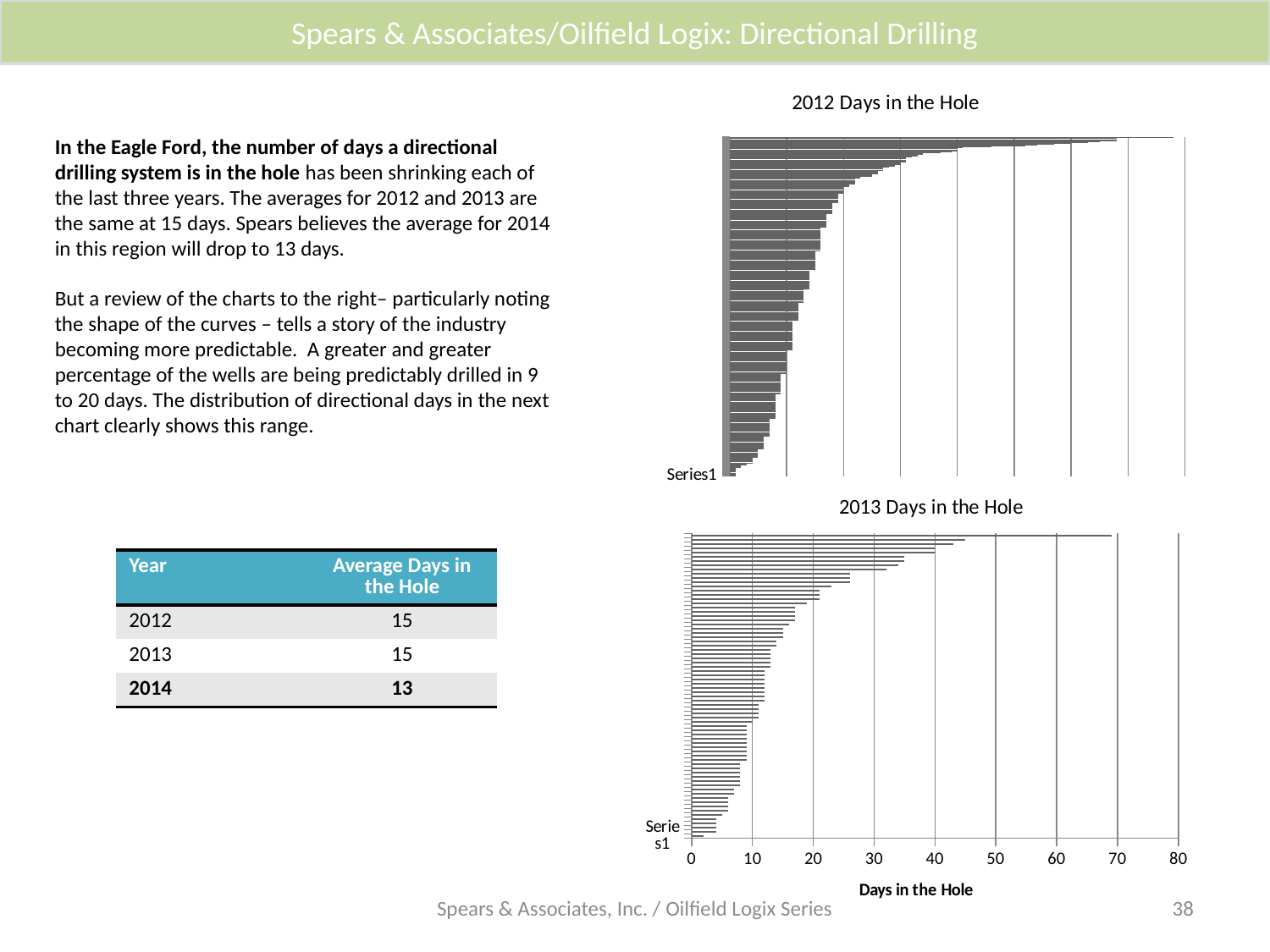
In the "2013 Days in the Hole" chart, is the value of the longest bar greater or less than 60? greater In the "2013 Days in the Hole" chart, is the value of the shortest bar greater or less than 10? less What kind of chart is the "2013 Days in the Hole" chart? bar chart What kind of chart is the "2012 Days in the Hole" chart? bar chart In the "2013 Days in the Hole" chart, is the value of the longest bar greater or less than 40? greater In the "2013 Days in the Hole" chart, do the bar lengths increase or decrease going from the top of the chart to the bottom? decrease In the "2012 Days in the Hole" chart, do the bar lengths increase or decrease going from the top of the chart to the bottom? decrease In the "2013 Days in the Hole" chart, what is the title of the horizontal axis? Days in the Hole What is the title of the upper chart on the slide? 2012 Days in the Hole